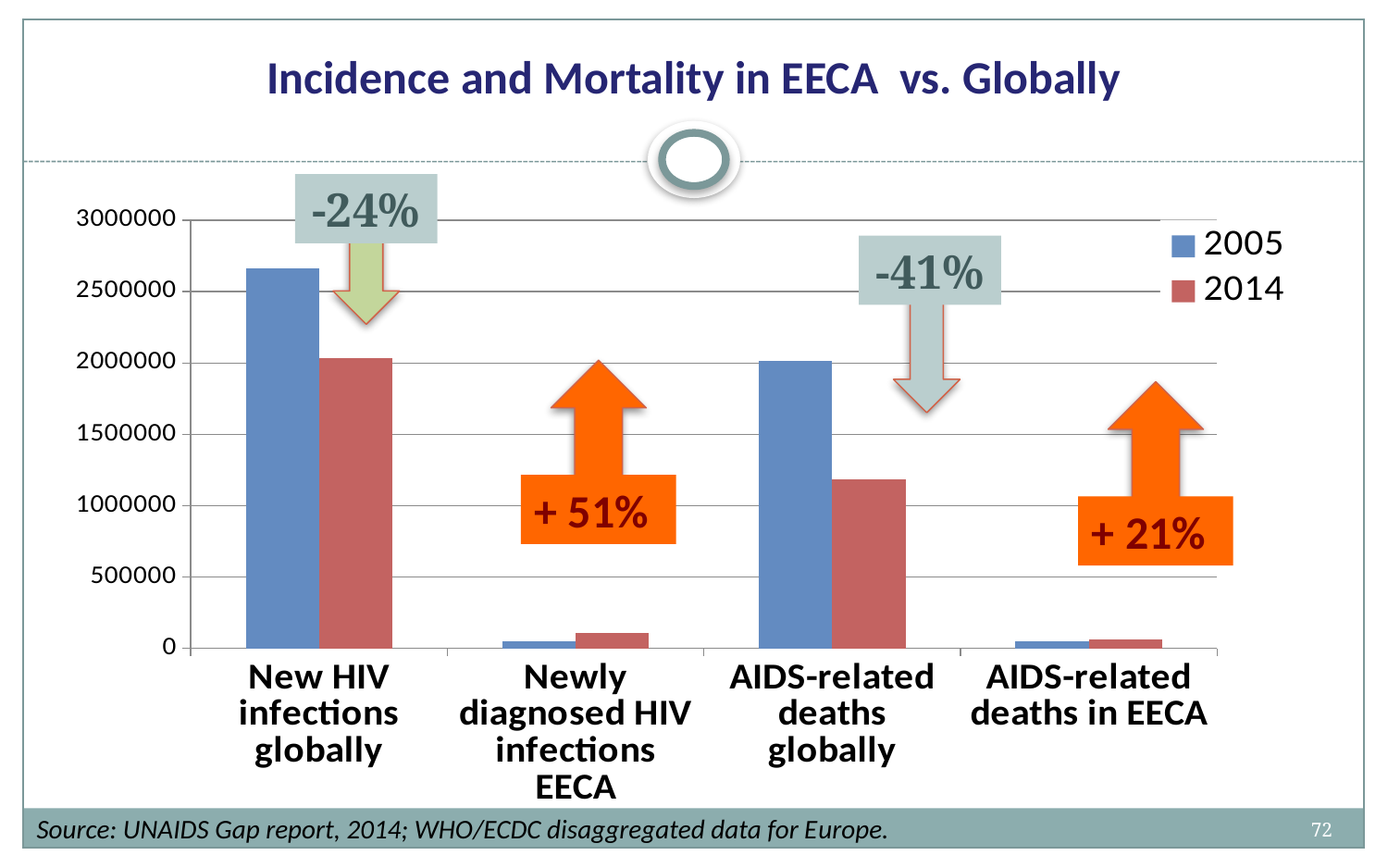
Is the 2005 value for New HIV infections globally greater or less than 2500000? greater For New HIV infections globally, which year has the larger value, 2005 or 2014? 2005 Which is larger in 2014: New HIV infections globally or AIDS-related deaths globally? New HIV infections globally What are the two series named in the legend? 2005 and 2014 What type of chart is shown on the slide? bar chart What percentage change is annotated above the AIDS-related deaths globally bars? -41% How many categories are shown on the x axis of the chart? 4 Is the 2005 value for AIDS-related deaths globally greater or less than 1500000? greater Is the 2014 value for AIDS-related deaths globally greater or less than 1500000? less How many series does the chart legend list? 2 What is the title of the chart? Incidence and Mortality in EECA vs. Globally Which category and series has the tallest bar in the chart? New HIV infections globally, 2005